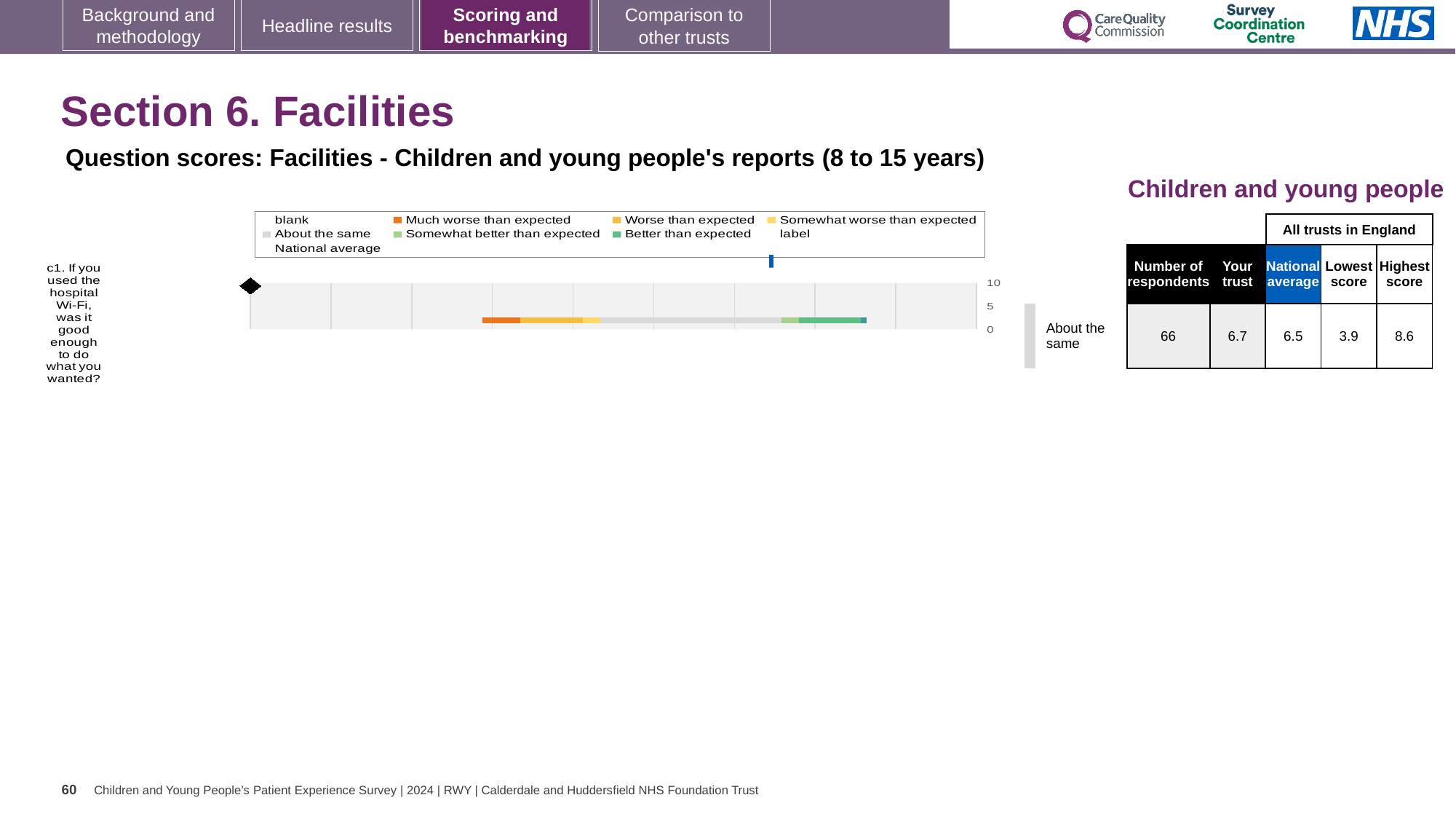
What is the difference between the trust's score and the national average for question c1? 0.2 How many questions (categories) are plotted in the chart? 1 What is the difference between the highest score and the lowest score for question c1? 4.7 What is the national average score for question c1 about hospital Wi-Fi? 6.5 What kind of chart is shown on the slide? bar chart Which is higher for question c1: the trust's score or the national average? Your trust What is the lowest score among all trusts in England for question c1? 3.9 What is the 'Your trust' score for question c1 about hospital Wi-Fi? 6.7 What is the highest tick value shown on the chart's axis? 10 How many respondents answered question c1 about hospital Wi-Fi? 66 Which benchmark category is shown for question c1 about hospital Wi-Fi? About the same What is the highest score among all trusts in England for question c1? 8.6